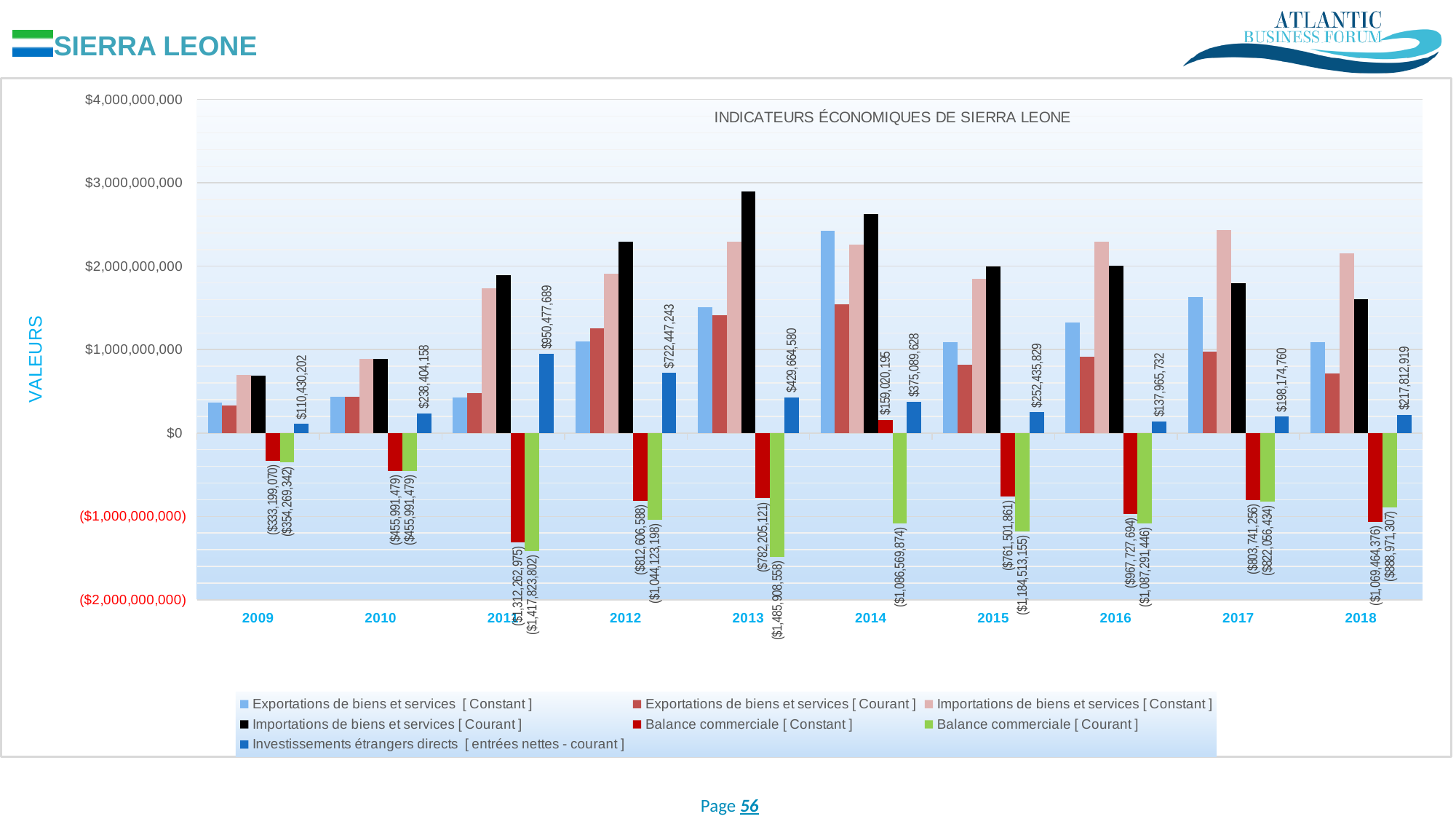
How many years are shown on the x axis of the chart? 10 What is the difference between Investissements étrangers directs in 2011 and in 2012? $228,030,446 Which year has the larger value for Exportations de biens et services [Constant], 2013 or 2014? 2014 How many series does the legend list? 7 What is the value of Investissements étrangers directs [entrées nettes - courant] in 2011? $950,477,689 What is the value of Balance commerciale [Constant] in 2014? $159,020,195 What is the value of Balance commerciale [Courant] in 2013? ($1,485,908,558) In which year is Investissements étrangers directs [entrées nettes - courant] the lowest? 2009 In which year is Investissements étrangers directs [entrées nettes - courant] the highest? 2011 Is the value of Importations de biens et services [Courant] in 2013 greater or less than $2,000,000,000? greater What type of chart is shown on the slide? bar chart What is the title of the chart? INDICATEURS ÉCONOMIQUES DE SIERRA LEONE